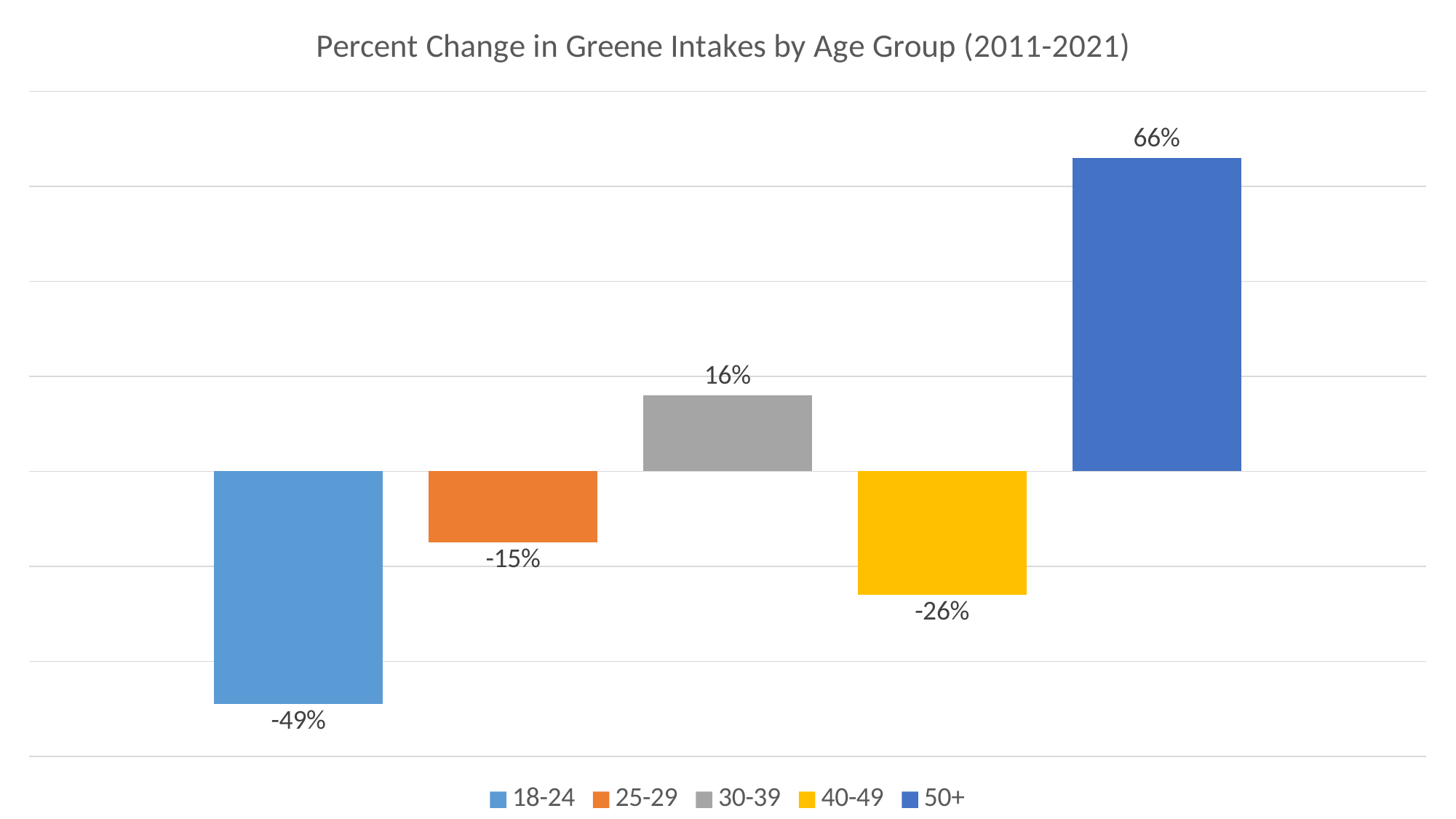
Which has a larger percent change, the 25-29 group or the 40-49 group? 25-29 What is the percent change in Greene intakes for the 40-49 age group? -26% What type of chart is shown on the slide? Bar chart What is the difference between the percent change for the 50+ group and the 30-39 group? 50 percentage points Which age group has the highest percent change in Greene intakes? 50+ How many age groups are shown in the chart? 5 What is the percent change in Greene intakes for the 30-39 age group? 16% What is the title of the chart? Percent Change in Greene Intakes by Age Group (2011-2021) What is the percent change in Greene intakes for the 18-24 age group? -49% Which age group has the lowest percent change in Greene intakes? 18-24 What is the percent change in Greene intakes for the 50+ age group? 66% How many entries does the legend list? 5